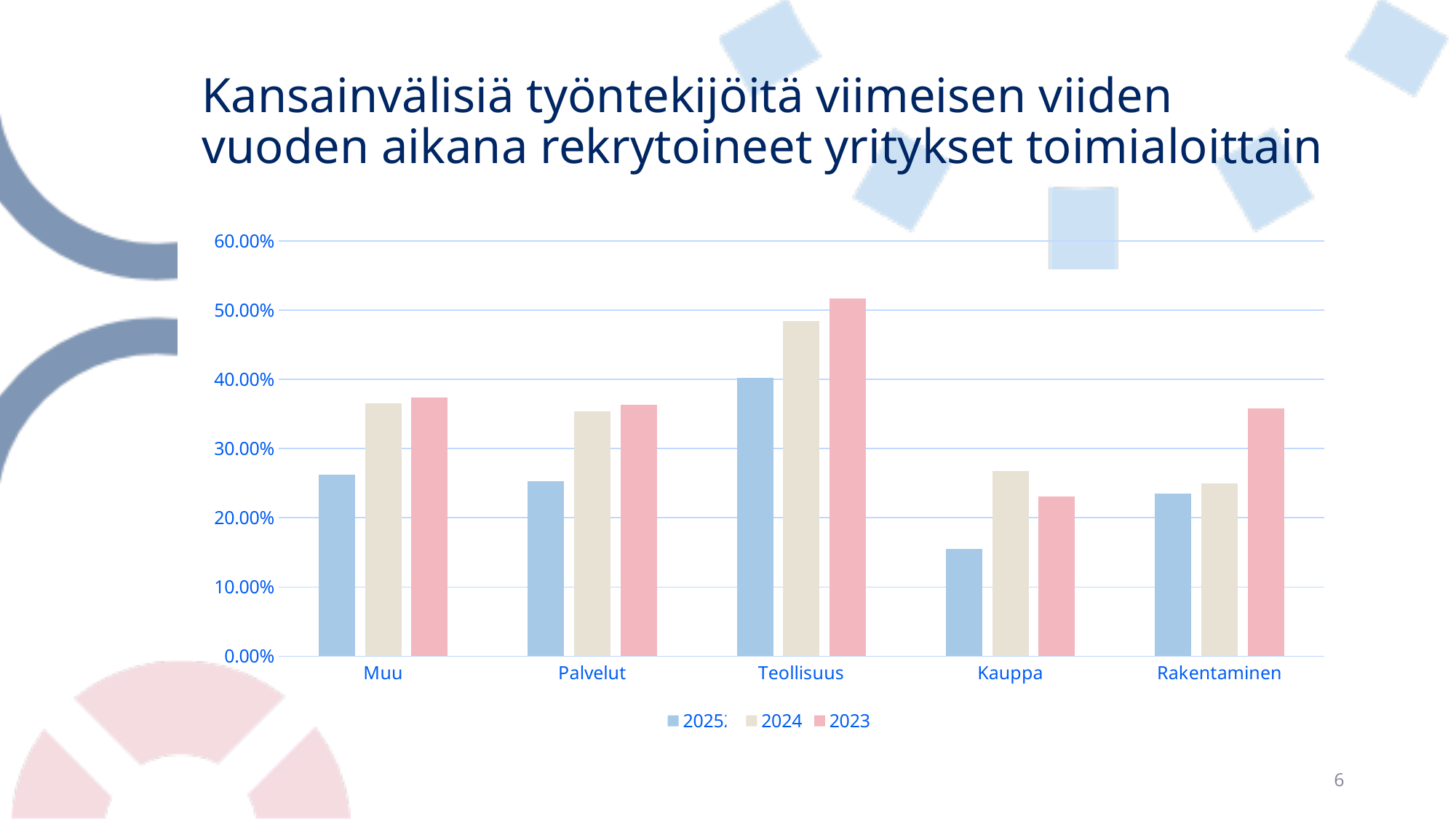
Is the 2023 value for Teollisuus greater or less than 50.00%? greater Which category has the lowest value for the 2025 series? Kauppa How many categories (toimialat) are shown on the x axis? 5 For Kauppa, which series has the larger value, 2024 or 2023? 2024 How many series does the legend list? 3 What is the title of the chart on the slide? Kansainvälisiä työntekijöitä viimeisen viiden vuoden aikana rekrytoineet yritykset toimialoittain What kind of chart is shown on the slide? Bar chart Which category has the highest value for the 2024 series? Teollisuus Which category has the highest value for the 2023 series? Teollisuus Is the 2025 value for Teollisuus greater or less than 30.00%? greater Is the 2025 value for Kauppa greater or less than 20.00%? less For Rakentaminen, which series has the larger value, 2023 or 2024? 2023